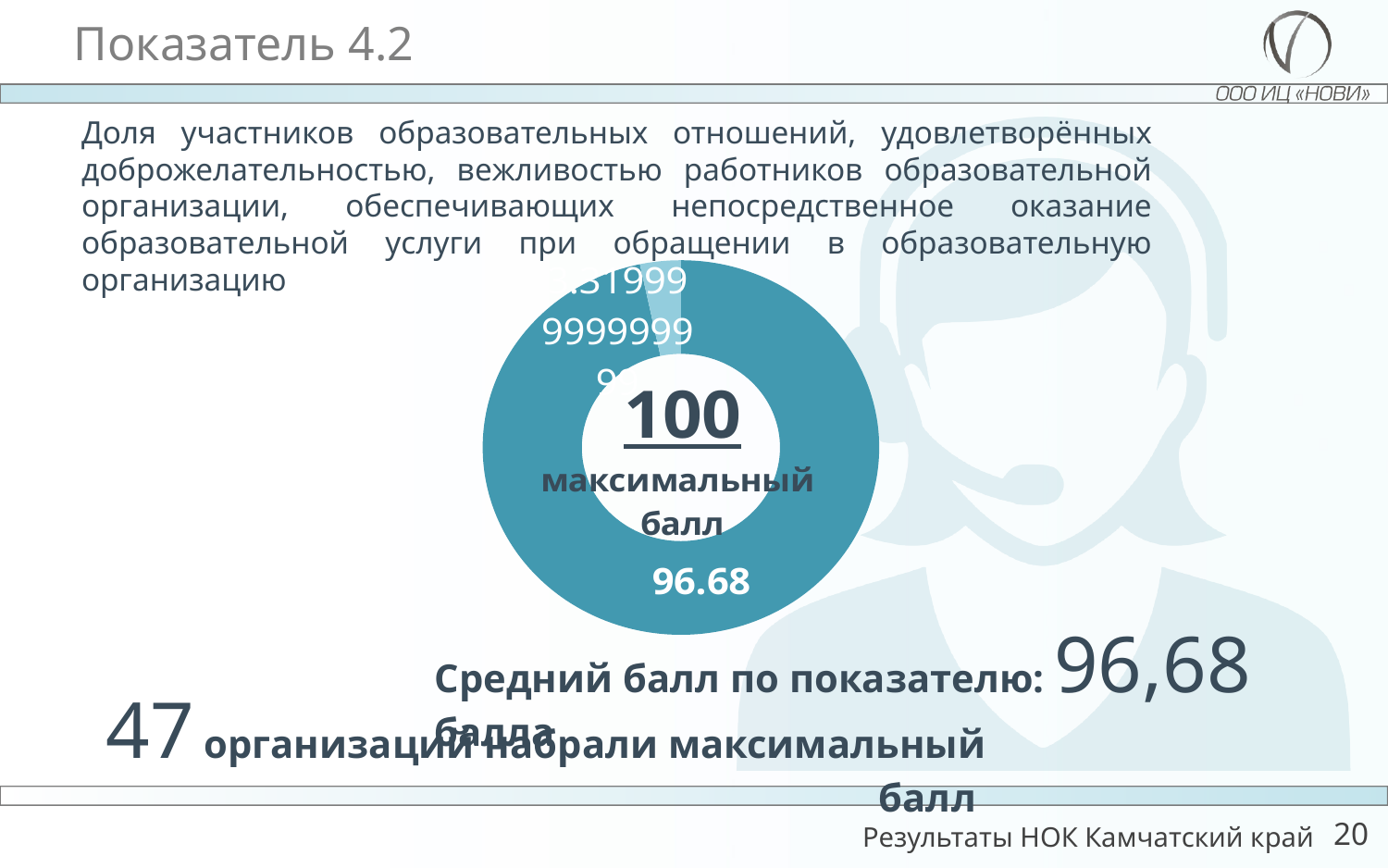
What text is written under the number in the centre of the doughnut chart? максимальный балл What value is printed as the data label on the large slice of the doughnut chart? 96.68 What number is printed in the centre of the doughnut chart? 100 Is the value of the large slice of the doughnut chart greater or less than 50? greater How many slices does the doughnut chart have? 2 What kind of chart is shown on the slide? Doughnut (pie) chart Which slice of the doughnut chart is larger: the one labelled 96.68 or the small slice at the top? The one labelled 96.68